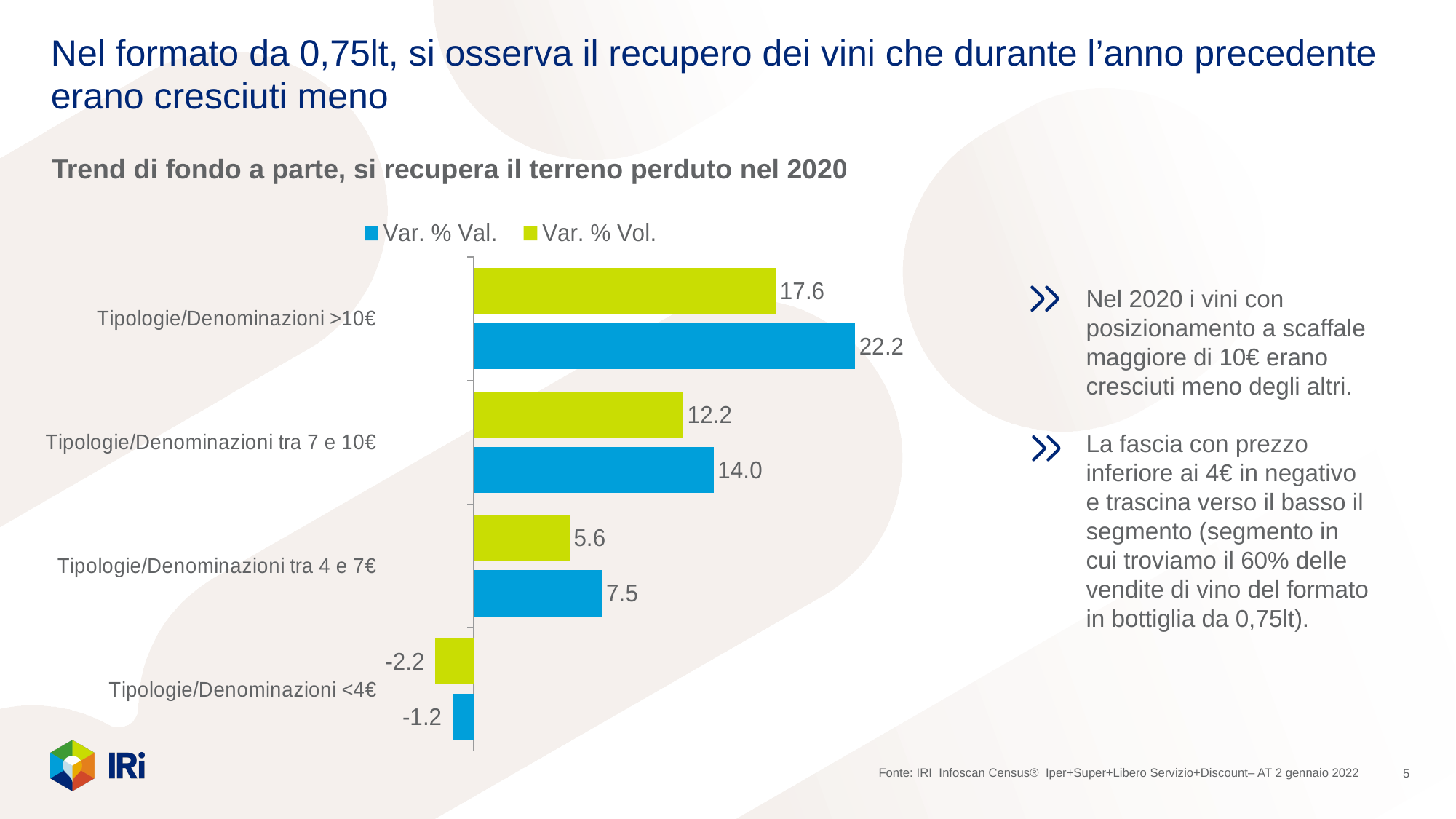
Which is larger for Tipologie/Denominazioni tra 7 e 10€: Var. % Val. or Var. % Vol.? Var. % Val. Which colour represents the Var. % Vol. series? Green What is the Var. % Vol. value for Tipologie/Denominazioni tra 7 e 10€? 12.2 What is the Var. % Val. value for Tipologie/Denominazioni >10€? 22.2 What is the difference between the Var. % Val. and Var. % Vol. values for Tipologie/Denominazioni >10€? 4.6 Which category has the lowest Var. % Vol. value? Tipologie/Denominazioni <4€ How many categories are shown on the chart? 4 What is the Var. % Val. value for Tipologie/Denominazioni tra 4 e 7€? 7.5 Which category has the highest Var. % Val. value? Tipologie/Denominazioni >10€ What is the Var. % Vol. value for Tipologie/Denominazioni <4€? -2.2 What kind of chart is shown on the slide? Bar chart How many series does the legend list? 2